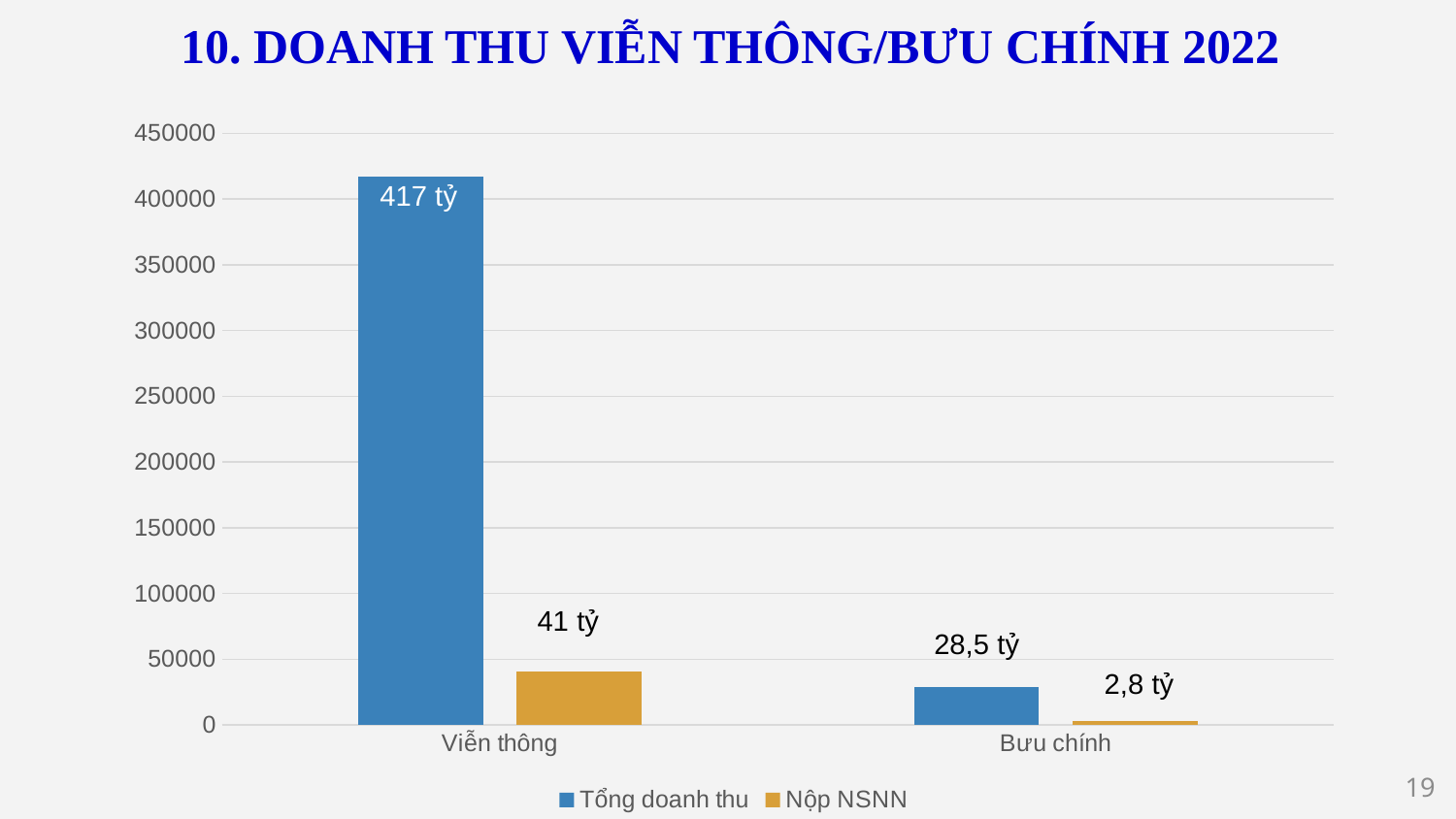
Which category has the highest Tổng doanh thu? Viễn thông What is the difference between Tổng doanh thu and Nộp NSNN for Bưu chính? 25,7 tỷ Which category has the lowest Nộp NSNN? Bưu chính What type of chart is shown on the slide? Bar chart Is the Tổng doanh thu bar for Viễn thông greater or less than 400000 on the axis? greater What is the Nộp NSNN value for Viễn thông? 41 tỷ What is the Tổng doanh thu value for Bưu chính? 28,5 tỷ Which is larger: Nộp NSNN for Viễn thông or Tổng doanh thu for Bưu chính? Nộp NSNN for Viễn thông How many series does the legend list? 2 What is the Nộp NSNN value for Bưu chính? 2,8 tỷ What is the difference between Tổng doanh thu and Nộp NSNN for Viễn thông? 376 tỷ What is the Tổng doanh thu value for Viễn thông? 417 tỷ